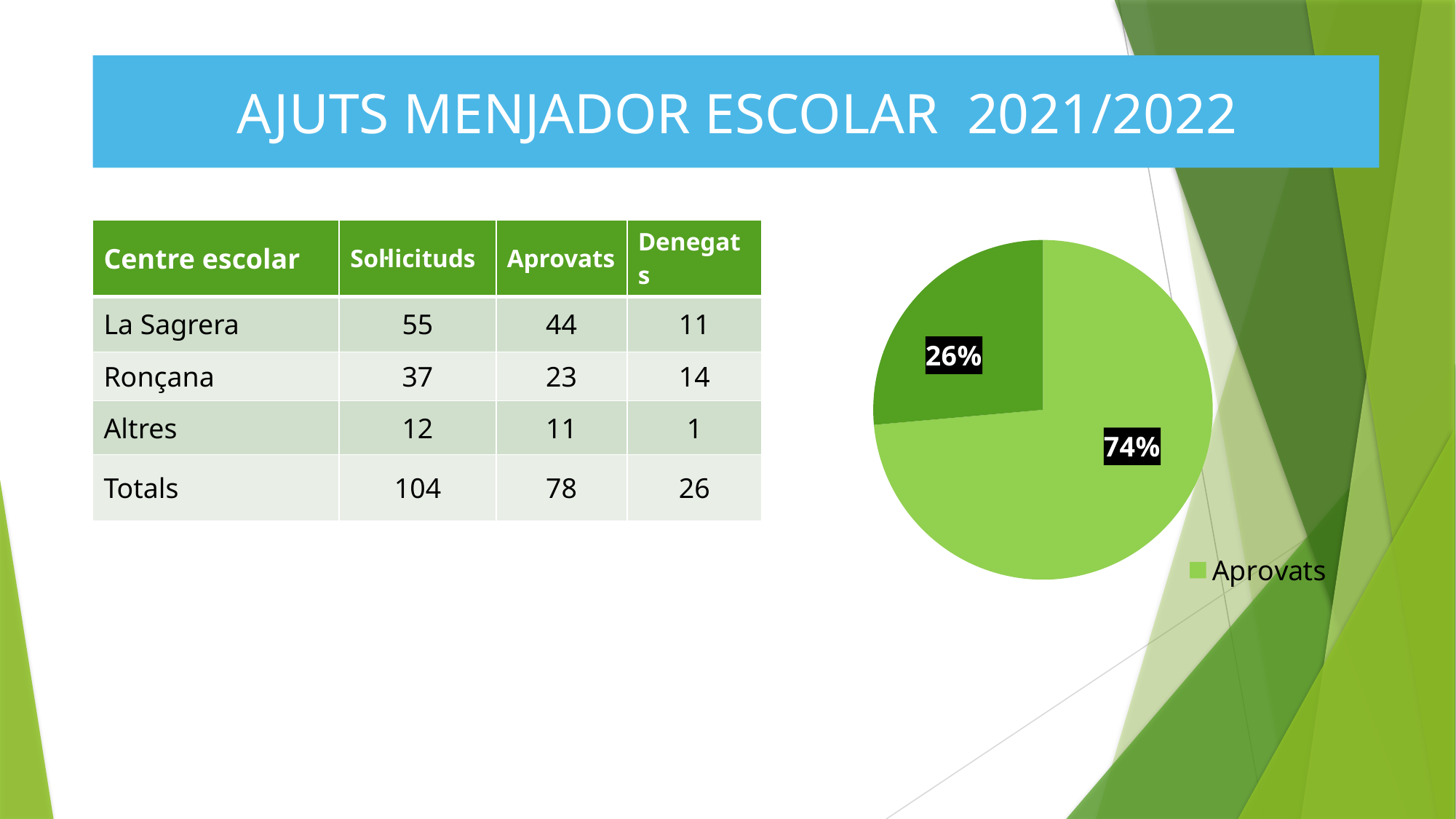
What legend entry is shown next to the pie chart? Aprovats What is the title of the slide containing the pie chart? AJUTS MENJADOR ESCOLAR 2021/2022 What do the two labelled slices of the pie chart add up to? 100% What kind of chart is shown on the right of the slide? pie chart Is the Aprovats slice of the pie chart greater or less than 50%? greater In the pie chart, what percentage is shown for the Aprovats slice? 74% What is the percentage of the smallest slice in the pie chart? 26% In the pie chart, what is the difference in percentage points between the 74% slice and the 26% slice? 48 percentage points In the pie chart, what percentage is shown on the smaller, dark green slice? 26% Which slice of the pie chart is the largest? Aprovats (74%) In the pie chart, is the Aprovats slice larger or smaller than the dark green slice? larger How many slices does the pie chart have? 2